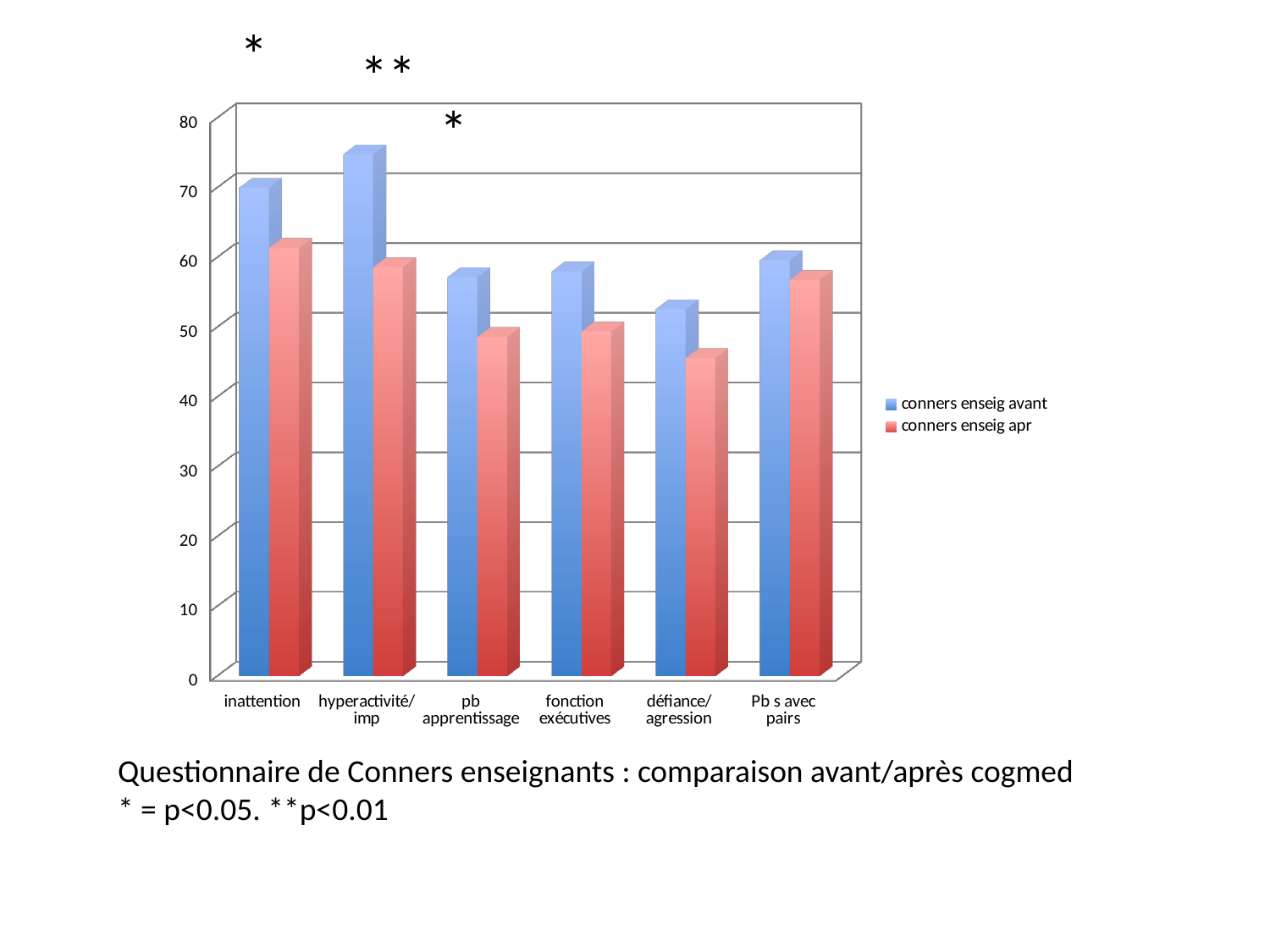
In every category, is the 'conners enseig avant' bar higher or lower than the 'conners enseig apr' bar? higher How many categories are shown along the x axis of the chart? 6 Which is larger: the 'conners enseig avant' value for 'inattention' or the 'conners enseig avant' value for 'pb apprentissage'? inattention For 'inattention', which series has the larger value, 'conners enseig avant' or 'conners enseig apr'? conners enseig avant Is the 'conners enseig avant' value for 'hyperactivité/imp' greater or less than 70? greater Is the 'conners enseig avant' value for 'inattention' greater or less than 60? greater Which category has the lowest value for the 'conners enseig apr' series? défiance/agression What kind of chart is shown on the slide? bar chart How many series does the legend list? 2 What are the two series names listed in the legend? conners enseig avant, conners enseig apr Which category has the highest value for the 'conners enseig avant' series? hyperactivité/imp Is the 'conners enseig apr' value for 'défiance/agression' greater or less than 50? less